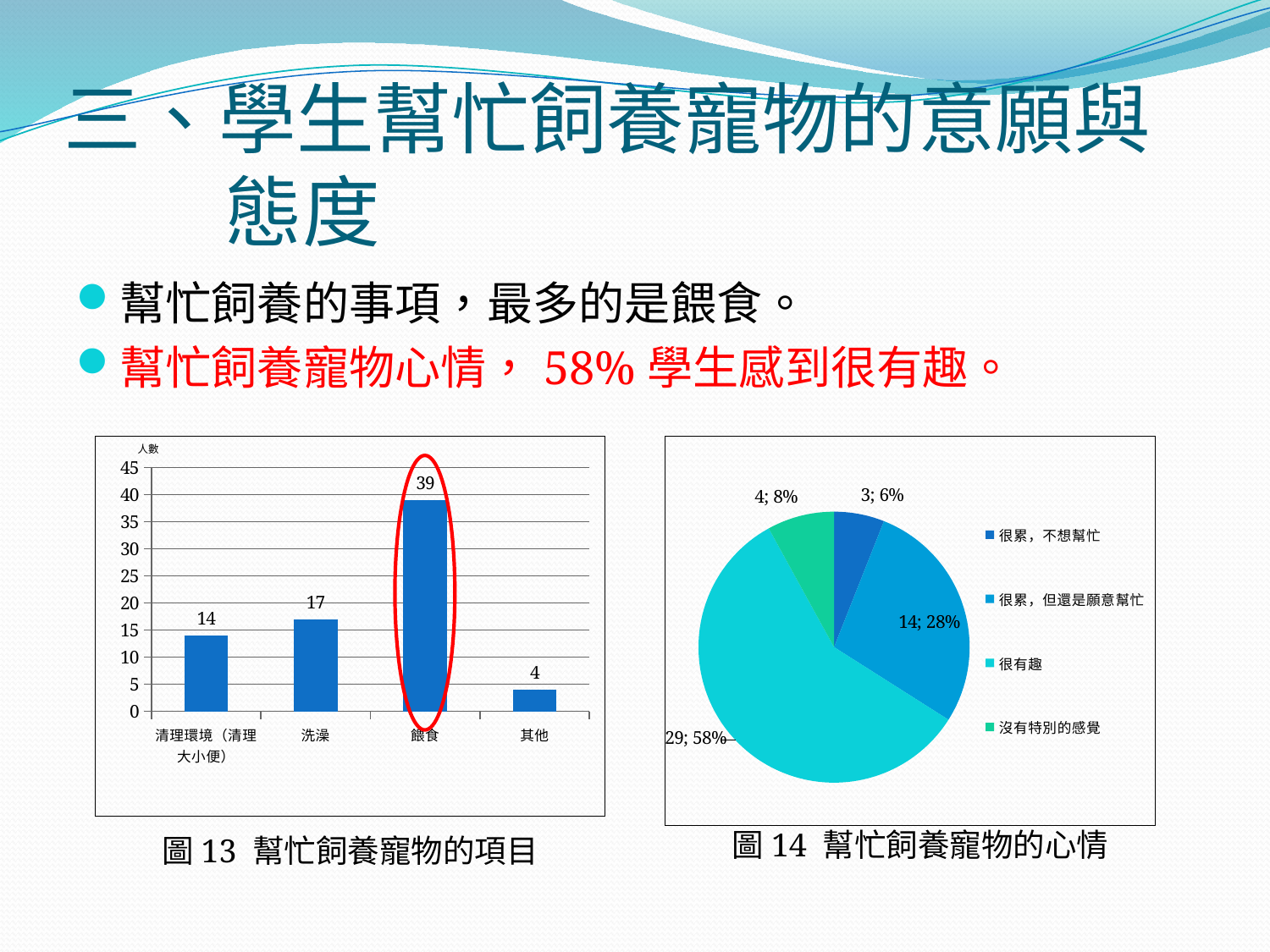
How many categories are shown in the bar chart 圖13 幫忙飼養寵物的項目? 4 How many entries does the legend of the pie chart 圖14 幫忙飼養寵物的心情 list? 4 In the bar chart 圖13 幫忙飼養寵物的項目, what is the value for 洗澡? 17 In the bar chart 圖13 幫忙飼養寵物的項目, which category has the highest value? 餵食 In the bar chart 圖13 幫忙飼養寵物的項目, which is larger, 洗澡 or 清理環境（清理大小便）? 洗澡 In the bar chart 圖13 幫忙飼養寵物的項目, which category has the lowest value? 其他 In the bar chart 圖13 幫忙飼養寵物的項目, what is the value for 餵食? 39 What type of chart is 圖13 幫忙飼養寵物的項目? bar chart In the pie chart 圖14 幫忙飼養寵物的心情, how many students answered 很累，但還是願意幫忙? 14 In the pie chart 圖14 幫忙飼養寵物的心情, what share does 很有趣 have? 58% In the pie chart 圖14 幫忙飼養寵物的心情, which category has the smallest slice? 很累，不想幫忙 In the bar chart 圖13 幫忙飼養寵物的項目, what is the difference between the values for 餵食 and 清理環境（清理大小便）? 25